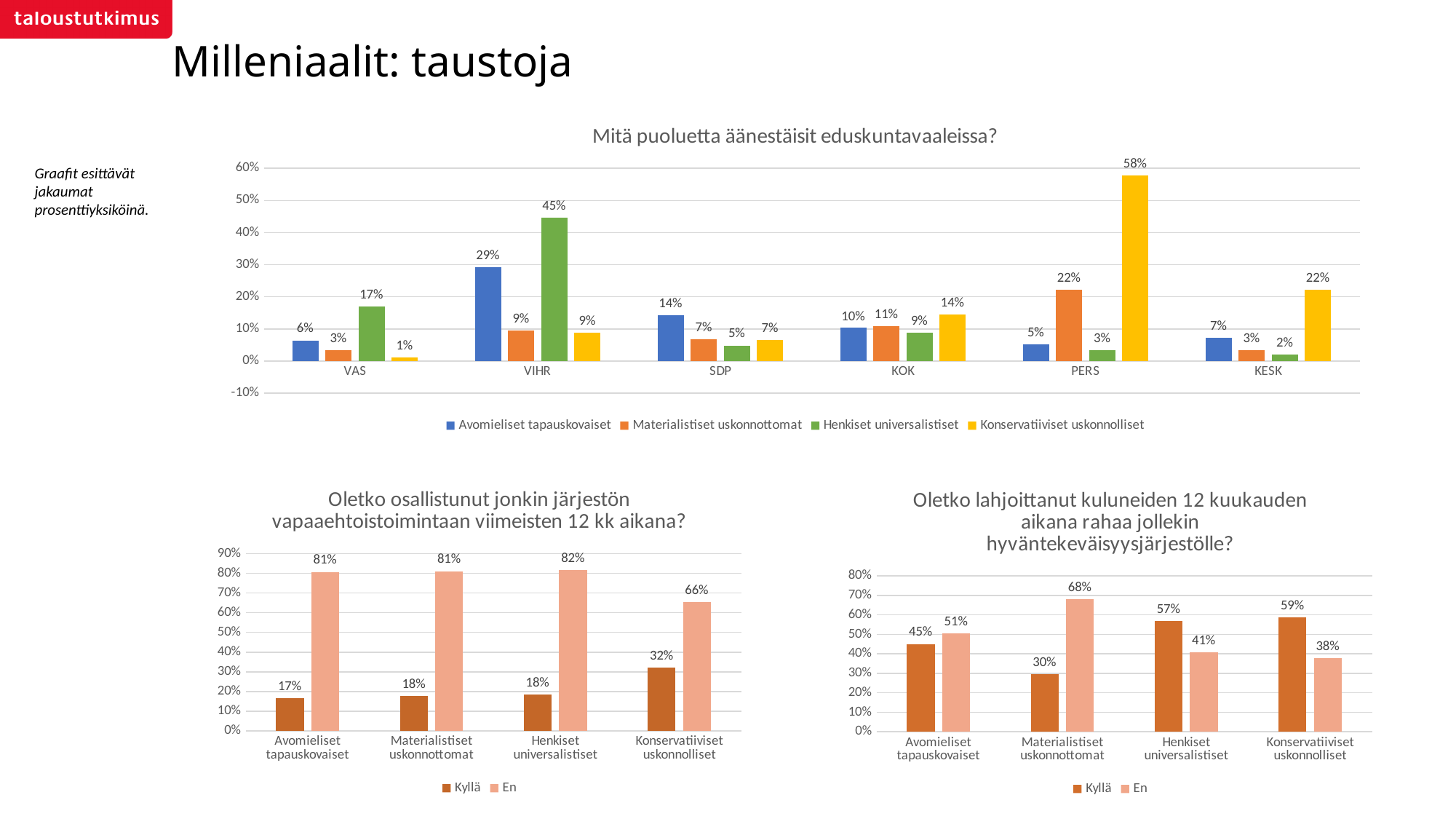
In the chart 'Mitä puoluetta äänestäisit eduskuntavaaleissa?', what is the difference between Materialistiset uskonnottomat at PERS and at KESK? 19% In the chart 'Mitä puoluetta äänestäisit eduskuntavaaleissa?', what is the value for Konservatiiviset uskonnolliset at PERS? 58% In the bottom-right chart 'Oletko lahjoittanut kuluneiden 12 kuukauden aikana rahaa jollekin hyväntekeväisyysjärjestölle?', what is the En value for Materialistiset uskonnottomat? 68% In the bottom-left chart 'Oletko osallistunut jonkin järjestön vapaaehtoistoimintaan viimeisten 12 kk aikana?', what is the Kyllä value for Konservatiiviset uskonnolliset? 32% In the bottom-right chart 'Oletko lahjoittanut kuluneiden 12 kuukauden aikana rahaa jollekin hyväntekeväisyysjärjestölle?', which is larger for Henkiset universalistiset, Kyllä or En? Kyllä How many series does the legend of the chart 'Mitä puoluetta äänestäisit eduskuntavaaleissa?' list? 4 How many parties are shown on the x axis of the chart 'Mitä puoluetta äänestäisit eduskuntavaaleissa?'? 6 In the chart 'Mitä puoluetta äänestäisit eduskuntavaaleissa?', what is the value for Henkiset universalistiset at VIHR? 45% In the chart 'Mitä puoluetta äänestäisit eduskuntavaaleissa?', which party has the highest value for Avomieliset tapauskovaiset? VIHR In the chart 'Mitä puoluetta äänestäisit eduskuntavaaleissa?', which party has the lowest value for Konservatiiviset uskonnolliset? VAS What kind of chart is the bottom-right chart 'Oletko lahjoittanut kuluneiden 12 kuukauden aikana rahaa jollekin hyväntekeväisyysjärjestölle?'? Bar chart In the bottom-left chart 'Oletko osallistunut jonkin järjestön vapaaehtoistoimintaan viimeisten 12 kk aikana?', which group has the lowest En value? Konservatiiviset uskonnolliset